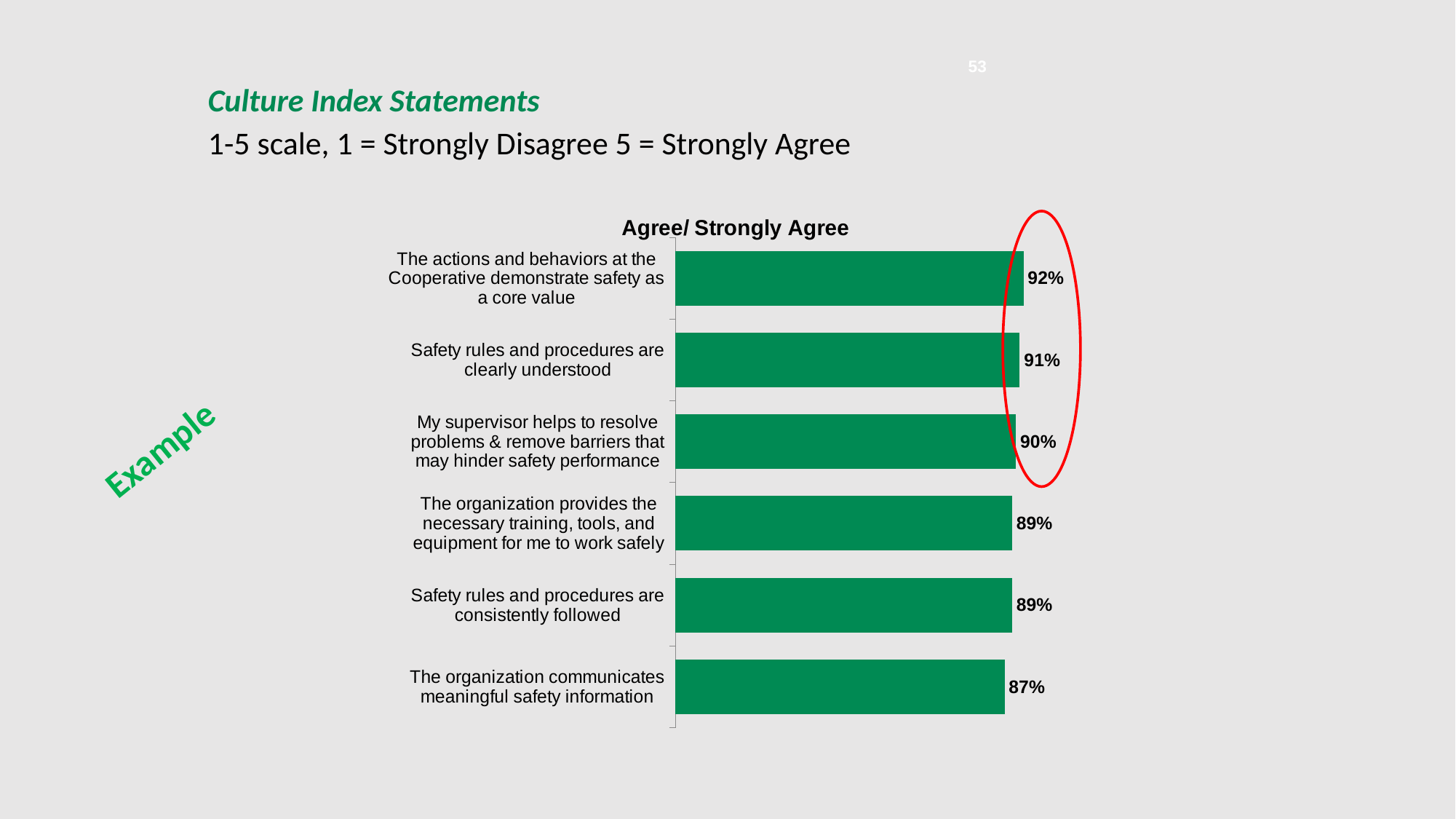
Which statement has the highest Agree/Strongly Agree percentage? The actions and behaviors at the Cooperative demonstrate safety as a core value Which has a higher value: "Safety rules and procedures are clearly understood" or "The organization provides the necessary training, tools, and equipment for me to work safely"? Safety rules and procedures are clearly understood What is the title of the chart? Agree/ Strongly Agree What is the value for "The organization communicates meaningful safety information"? 87% How many statements are shown in the chart? 6 Which statement has the lowest Agree/Strongly Agree percentage? The organization communicates meaningful safety information What is the value for "My supervisor helps to resolve problems & remove barriers that may hinder safety performance"? 90% What kind of chart is shown on the slide? Bar chart What is the value for "Safety rules and procedures are clearly understood"? 91% What percentage agreed or strongly agreed that the actions and behaviors at the Cooperative demonstrate safety as a core value? 92% What is the difference between the values for "Safety rules and procedures are clearly understood" and "Safety rules and procedures are consistently followed"? 2% What is the difference between the highest and lowest percentages shown in the chart? 5%